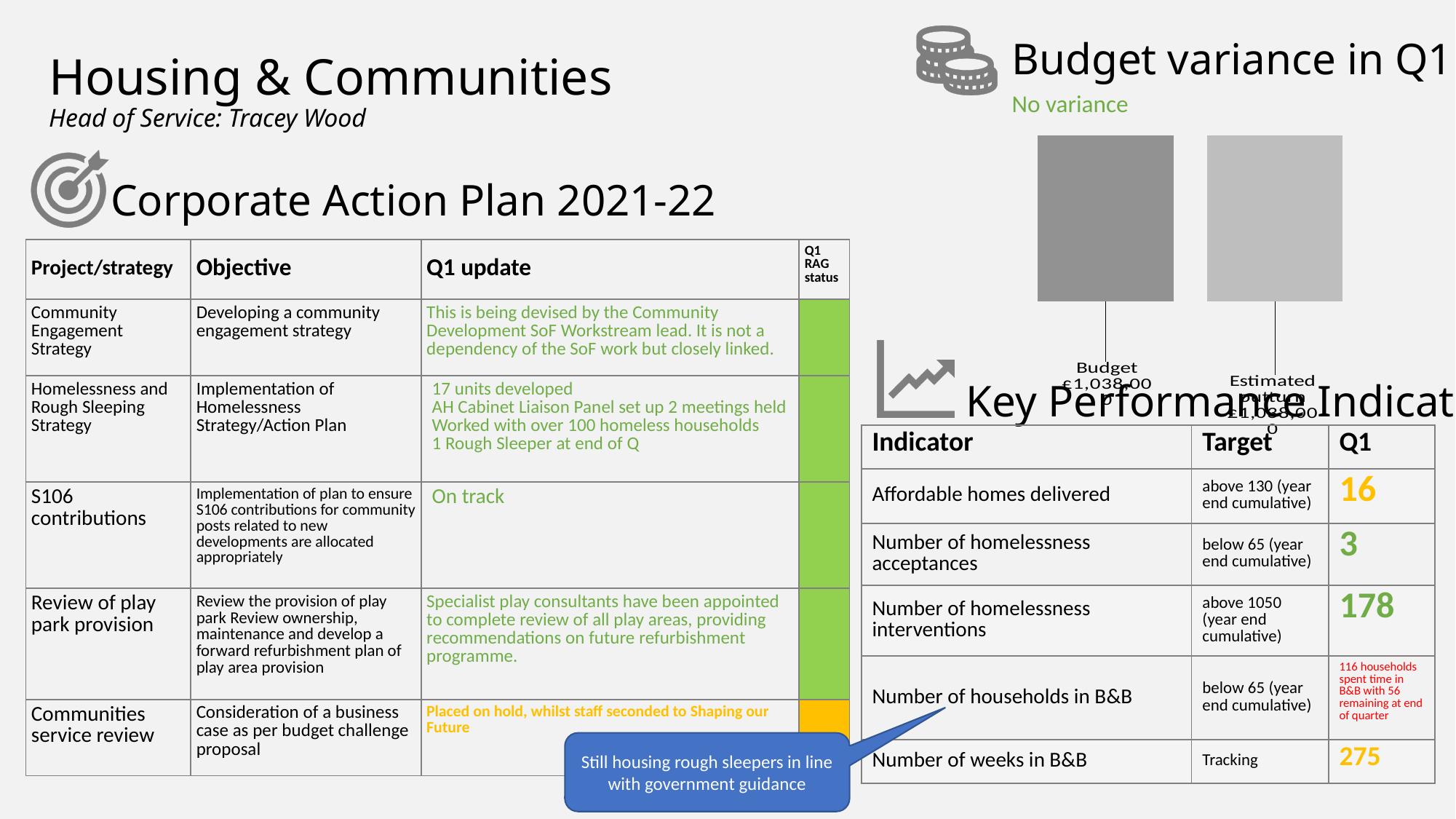
Is the Budget bar in the 'Budget variance in Q1' chart taller or shorter than the Estimated Outturn bar? Neither, they are the same height In the 'Budget variance in Q1' chart, what is the difference between the Budget and the Estimated Outturn? £0 What does the text beneath the 'Budget variance in Q1' heading say about the variance? No variance What are the two categories plotted in the 'Budget variance in Q1' chart? Budget and Estimated Outturn How many bars does the 'Budget variance in Q1' chart show? 2 What is the Estimated Outturn value shown in the 'Budget variance in Q1' chart? £1,038,000 What kind of chart is shown under the 'Budget variance in Q1' heading? Bar chart What is the Budget value shown in the 'Budget variance in Q1' chart? £1,038,000